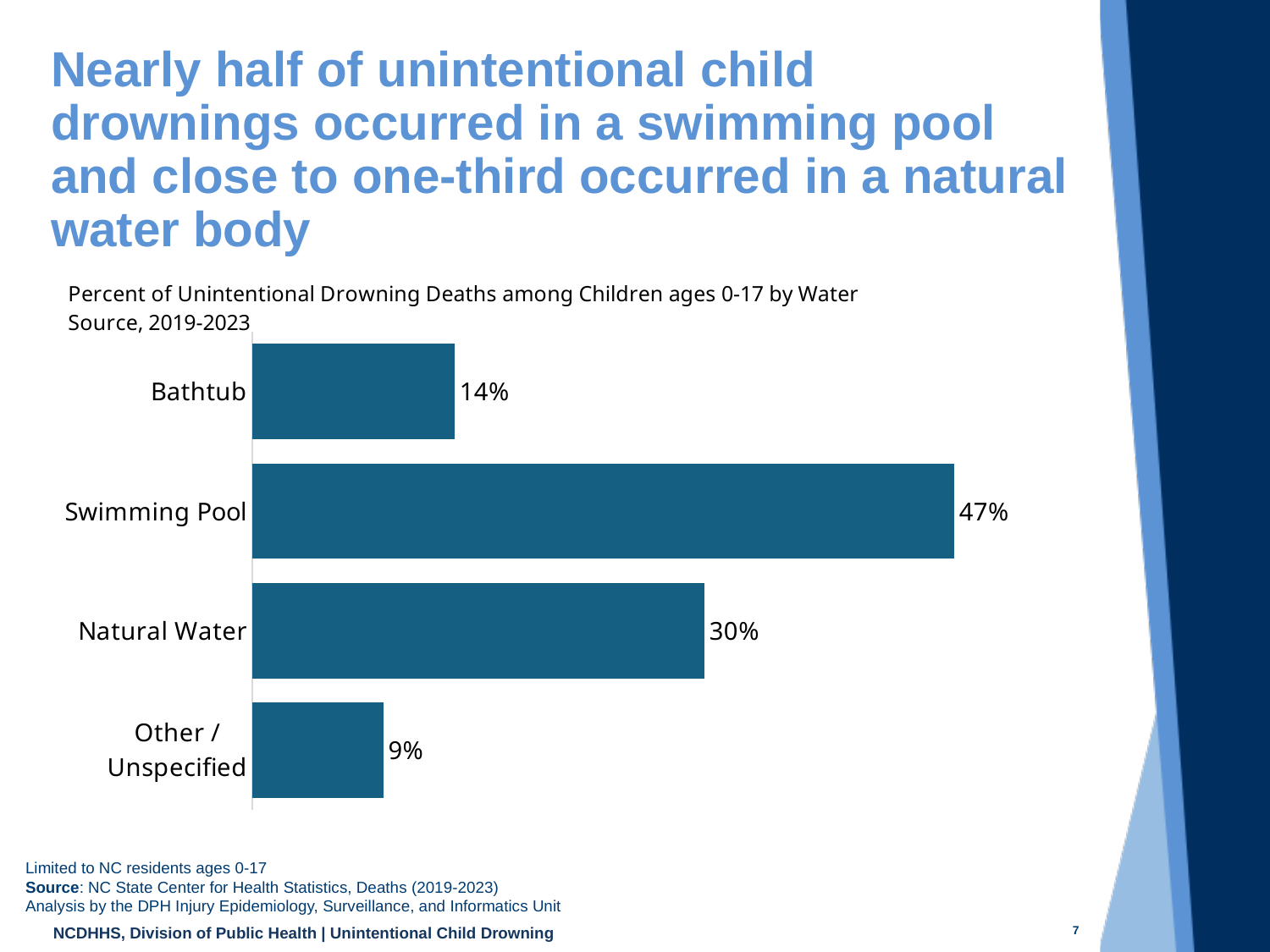
How many water source categories are shown in the chart? 4 What kind of chart is shown on the slide? Bar chart What is the difference in percentage points between Swimming Pool and Natural Water? 17 Which is larger, the percent for Bathtub or the percent for Natural Water? Natural Water What percent of unintentional drowning deaths fall under Other / Unspecified? 9% Which water source has the lowest percent of unintentional drowning deaths? Other / Unspecified What percent of unintentional drowning deaths occurred in a bathtub? 14% Which water source has the highest percent of unintentional drowning deaths? Swimming Pool What percent of unintentional drowning deaths occurred in natural water? 30% What years does the chart's title say the data covers? 2019-2023 What percent of unintentional drowning deaths occurred in a swimming pool? 47% What is the difference in percentage points between Bathtub and Other / Unspecified? 5